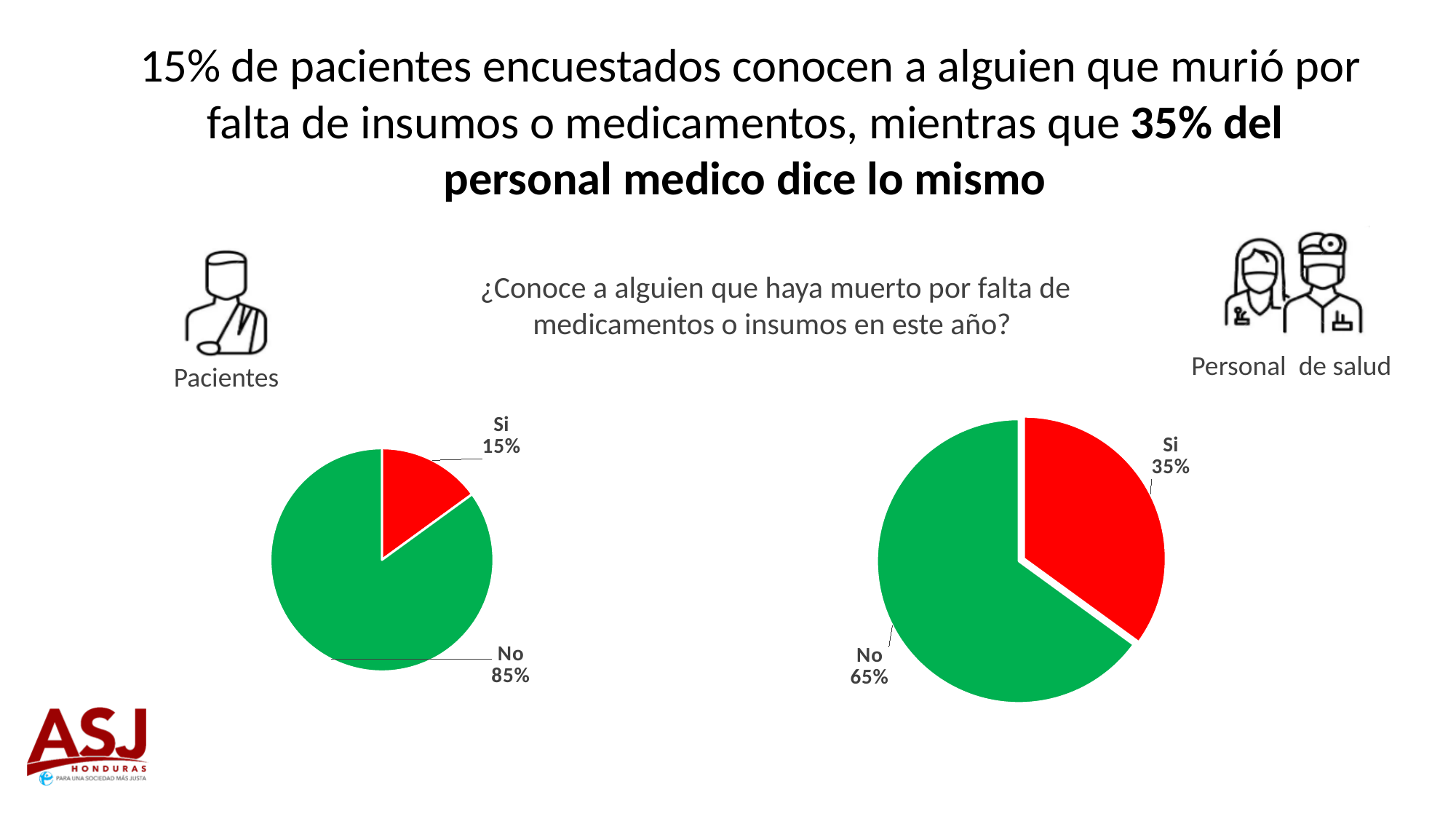
In the Personal de salud pie chart on the right, what percentage answered Si? 35% What colour is the Si slice in both pie charts? Red In the Pacientes pie chart on the left, what share of the pie does the Si slice represent? 15% In the Pacientes pie chart on the left, what percentage answered No? 85% In the Personal de salud pie chart on the right, what percentage answered No? 65% What is the difference between the Si share in the Personal de salud chart and the Si share in the Pacientes chart? 20% In the Personal de salud pie chart on the right, which answer has the smallest slice? Si What type of chart is used for the Pacientes data on the left? Pie chart In the Pacientes pie chart on the left, what percentage answered Si? 15% Which is larger: the No share in the Pacientes chart or the No share in the Personal de salud chart? Pacientes (85%) How many slices does the Personal de salud pie chart on the right have? 2 In the Pacientes pie chart on the left, which answer has the largest slice? No